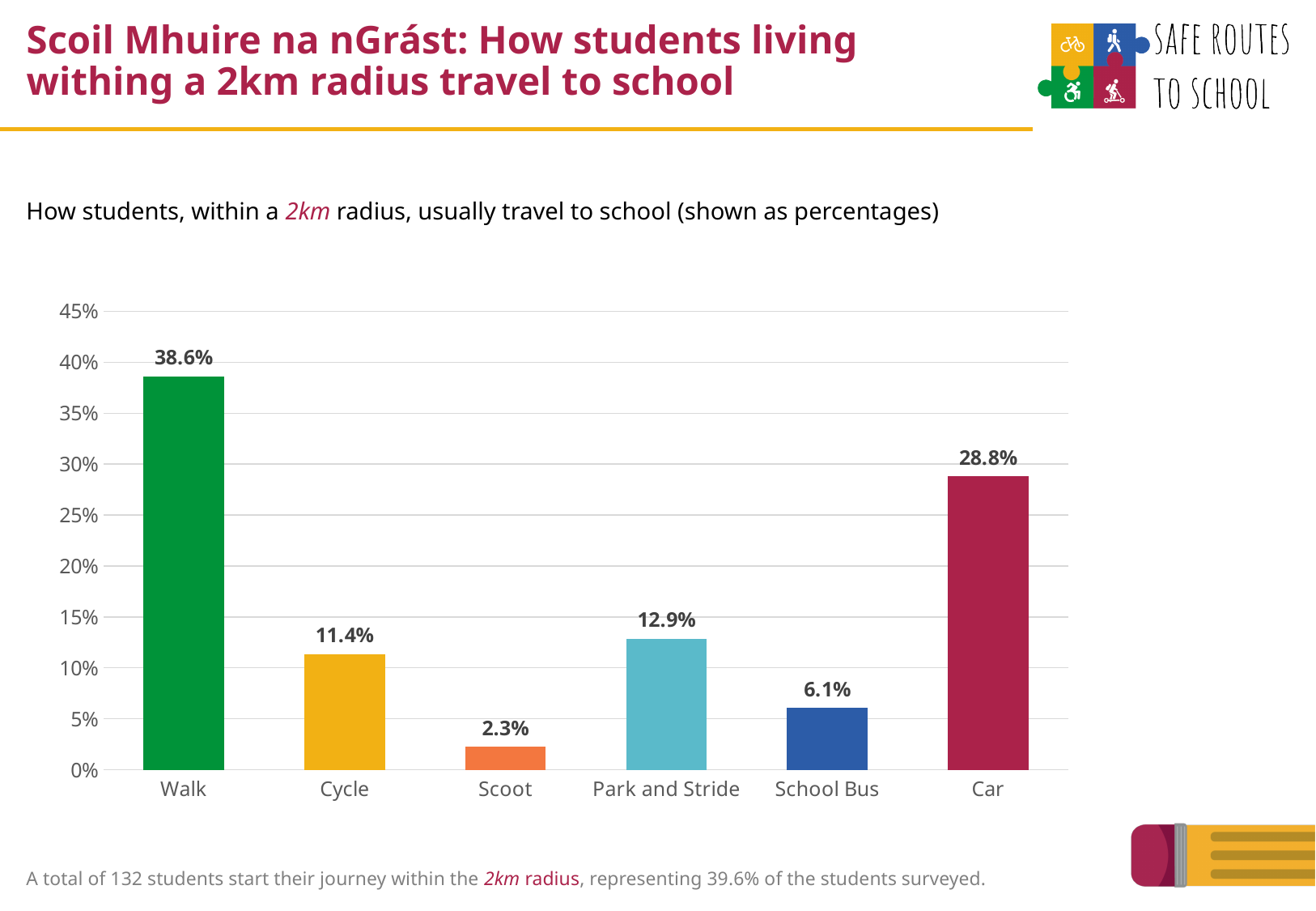
How many modes of travel are shown on the chart? 6 What is the difference in percentage points between Walk and Car? 9.8 Which mode of travel has the highest percentage? Walk Is the value for Car greater or less than 30%? less What percentage of students travel to school by School Bus? 6.1% What is the value shown for Park and Stride? 12.9% What is the highest value labelled on the vertical axis? 45% Which mode of travel has the lowest percentage? Scoot Which is larger, the value for Cycle or the value for School Bus? Cycle What is the difference in percentage points between Park and Stride and Cycle? 1.5 What percentage of students within the 2km radius usually walk to school? 38.6% What kind of chart is shown on the slide? bar chart